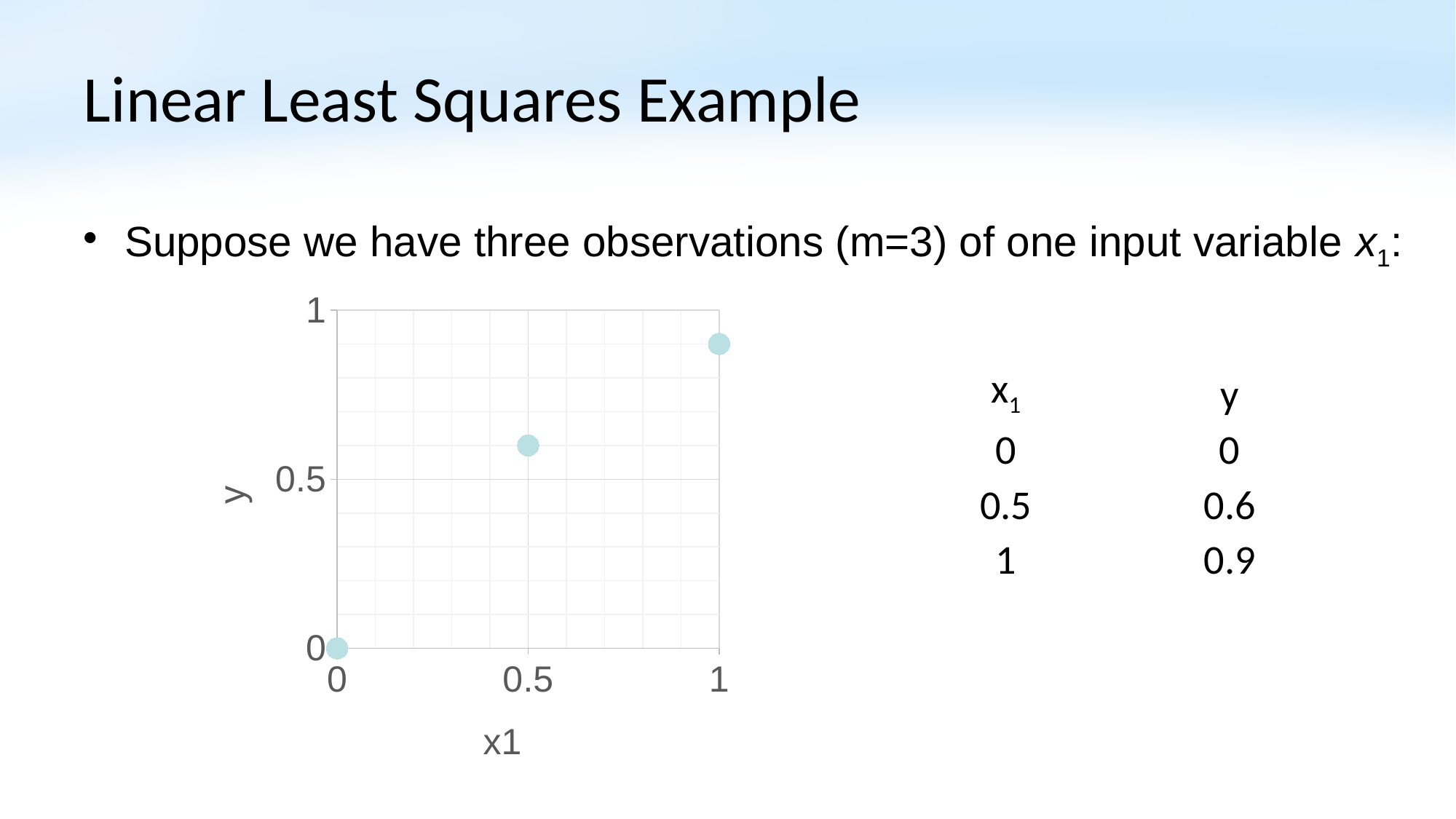
What is the y value of the point at x1 = 0.5? 0.6 Which x1 value has the lowest y value? 0 What is the difference in y between the points at x1 = 1 and x1 = 0.5? 0.3 What is the y value of the point at x1 = 0? 0 What is the y value of the point at x1 = 1? 0.9 What is the label of the horizontal axis of the chart? x1 Do the y values rise or fall as x1 increases? rise How many data points are plotted in the chart? 3 Which x1 value has the highest y value? 1 Which point has a larger y value, the one at x1 = 0.5 or the one at x1 = 1? x1 = 1 What kind of chart is shown on the slide? scatter plot Is the y value of the point at x1 = 0.5 greater or less than 0.5? greater